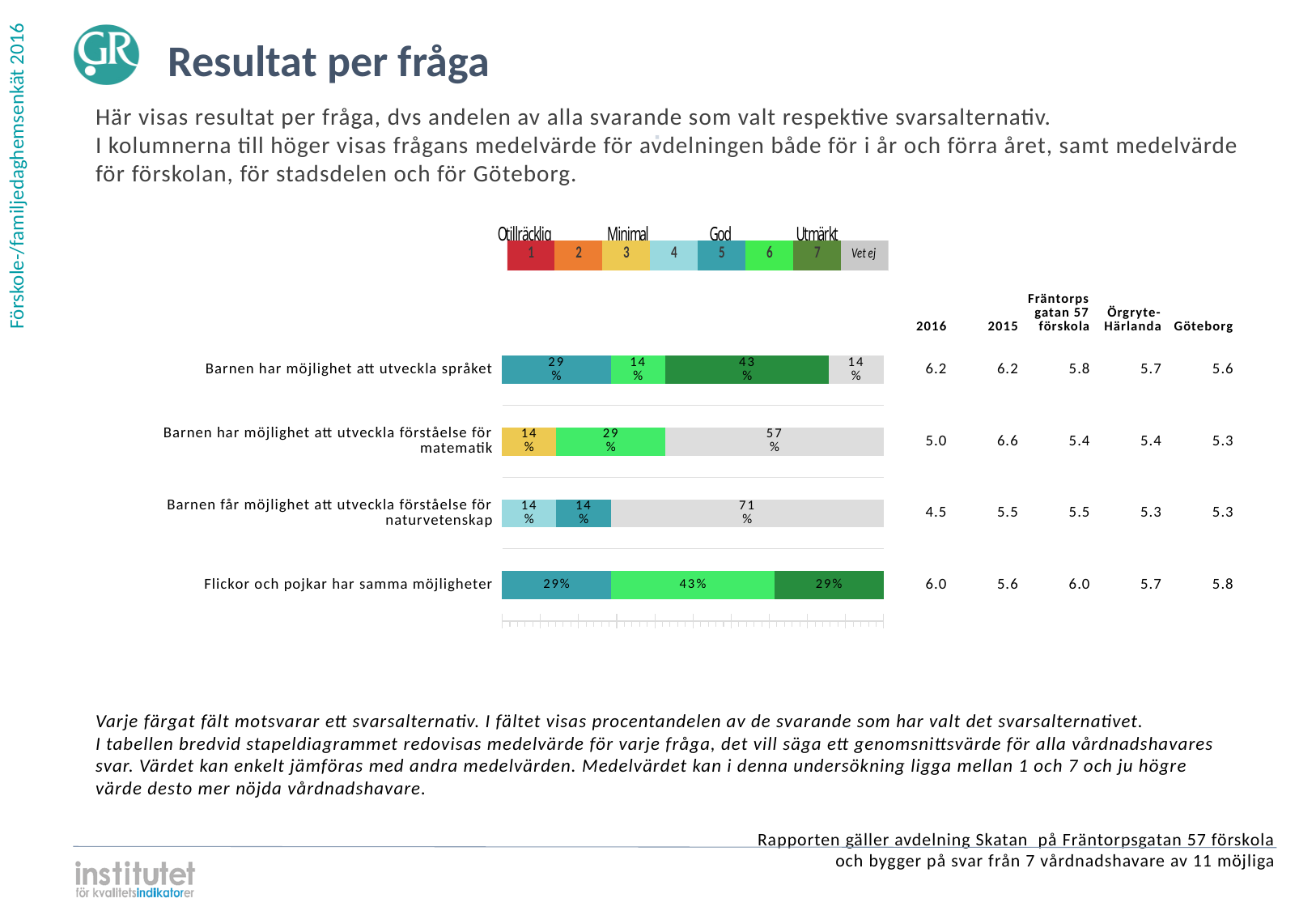
Which is larger: the share choosing 7 for 'Barnen har möjlighet att utveckla språket' or the share choosing 7 for 'Flickor och pojkar har samma möjligheter'? Barnen har möjlighet att utveckla språket What percentage of respondents answered 'Vet ej' for 'Barnen får möjlighet att utveckla förståelse för naturvetenskap'? 71% What percentage of respondents chose 6 for 'Flickor och pojkar har samma möjligheter'? 43% Which response option in the legend is shown in grey? Vet ej How many questions (categories) are plotted in the bar chart? 4 What percentage of respondents chose 7 (Utmärkt) for 'Barnen har möjlighet att utveckla språket'? 43% Which question has the largest 'Vet ej' share? Barnen får möjlighet att utveckla förståelse för naturvetenskap How many response options does the legend above the chart list, including 'Vet ej'? 8 What is the combined share of respondents choosing 5, 6 or 7 for 'Flickor och pojkar har samma möjligheter'? 101% What percentage of respondents chose 3 for 'Barnen har möjlighet att utveckla förståelse för matematik'? 14% What is the difference between the 'Vet ej' share for 'Barnen har möjlighet att utveckla förståelse för matematik' and for 'Barnen har möjlighet att utveckla språket'? 43 percentage points What kind of chart is shown on the slide? stacked bar chart